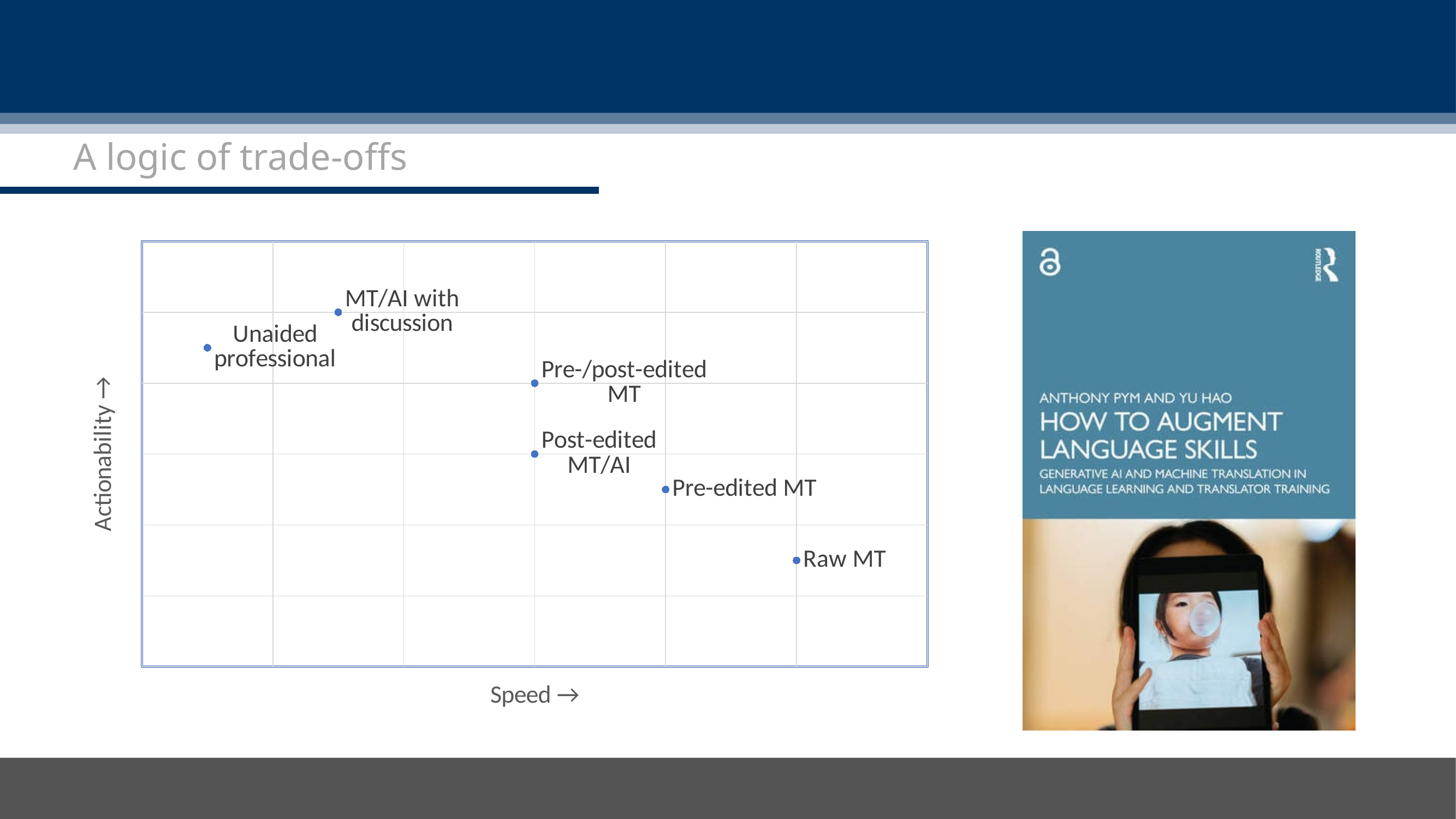
Which has higher actionability, Pre-edited MT or Raw MT? Pre-edited MT What kind of chart is shown on the slide? Scatter chart Which has higher actionability, Pre-/post-edited MT or Post-edited MT/AI? Pre-/post-edited MT As speed increases from Pre-/post-edited MT to Raw MT, does actionability rise or fall? Fall Which point has the lowest actionability? Raw MT What is the label of the horizontal axis? Speed → What is the label of the vertical axis? Actionability → Which point has the lowest speed? Unaided professional Which has higher speed, Unaided professional or MT/AI with discussion? MT/AI with discussion How many data points are plotted on the chart? 6 Which point has the highest actionability? MT/AI with discussion Which point has the highest speed? Raw MT